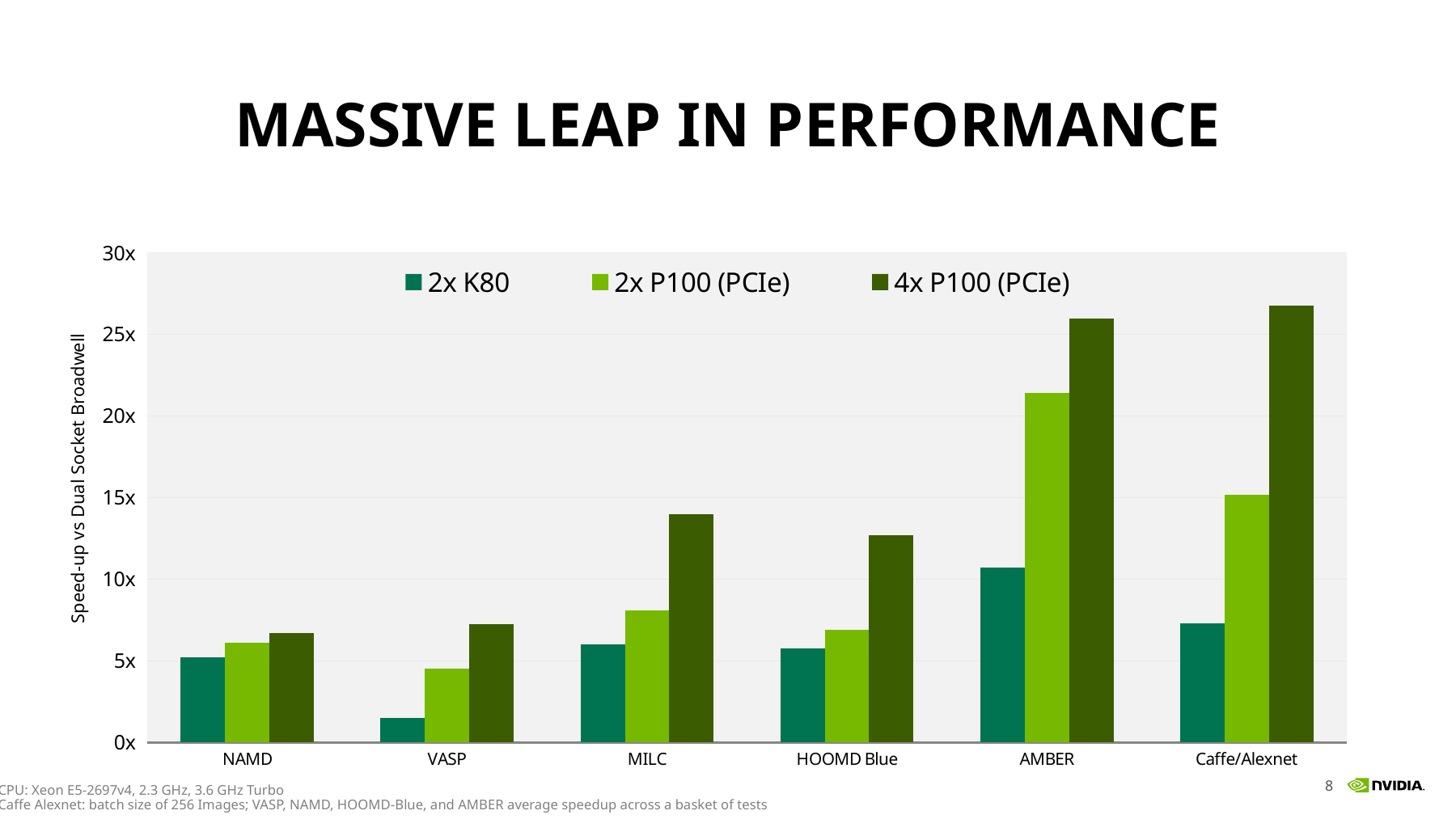
How many application categories are shown on the x axis? 6 For the 4x P100 (PCIe) series, which is larger: MILC or HOOMD Blue? MILC Which application has the highest speed-up for the 2x P100 (PCIe) series? AMBER What is the label on the vertical axis? Speed-up vs Dual Socket Broadwell Is the 2x K80 speed-up for VASP greater or less than 5x? less Which application has the highest speed-up for the 2x K80 series? AMBER Is the 4x P100 (PCIe) speed-up for MILC greater or less than 15x? less Which application has the lowest speed-up for the 2x K80 series? VASP Is the 2x P100 (PCIe) speed-up for AMBER greater or less than 20x? greater Which application has the lowest speed-up for the 2x P100 (PCIe) series? VASP How many series does the legend list? 3 What kind of chart is shown on the slide? bar chart